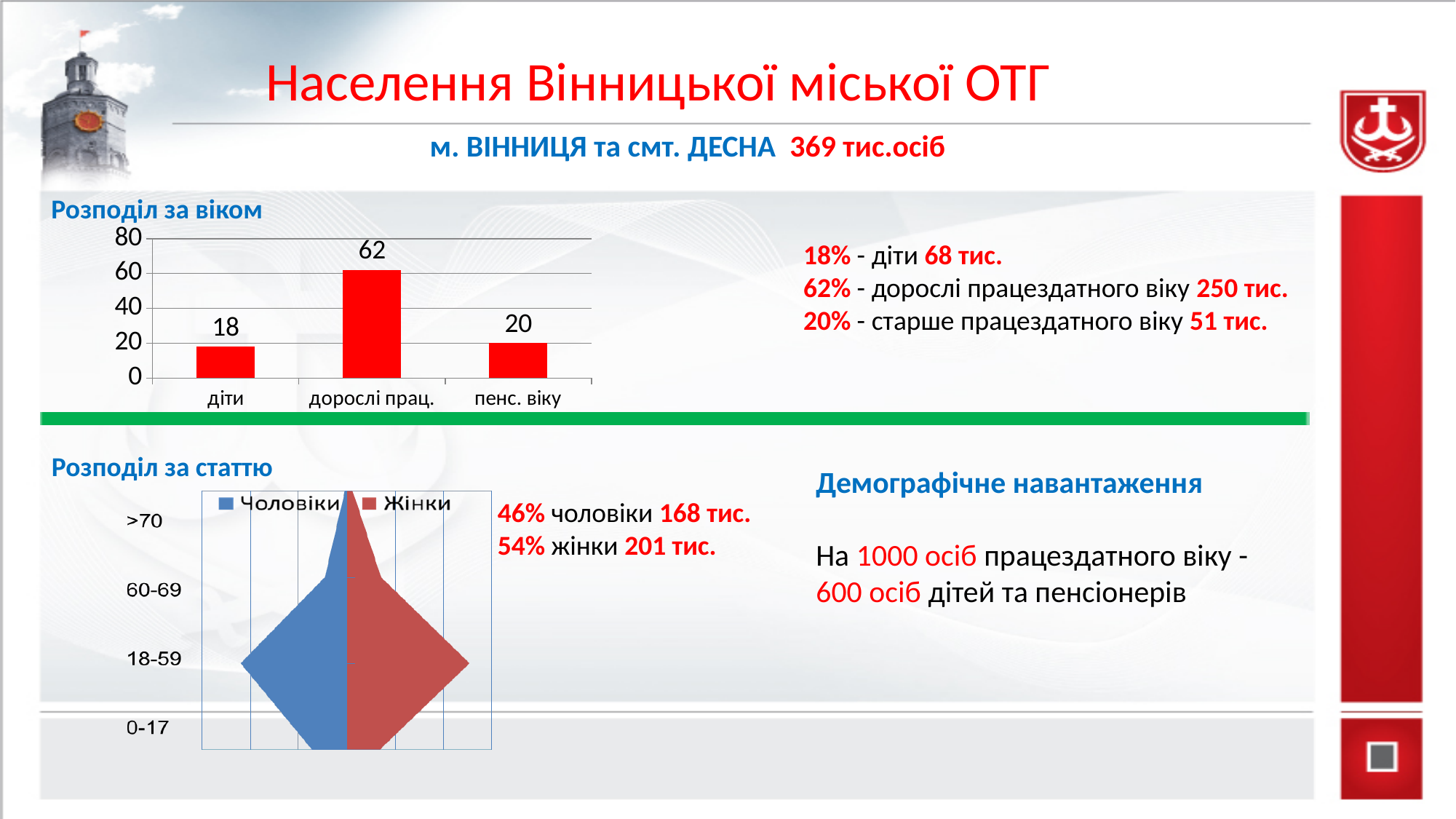
In the 'Розподіл за віком' chart, is the value for 'дорослі прац.' greater or less than 40? greater In the 'Розподіл за віком' chart, which category has the lowest value? діти In the 'Розподіл за віком' chart, what is the value for 'діти'? 18 How many series does the legend of the 'Розподіл за статтю' chart list? 2 In the 'Розподіл за статтю' chart, which colour represents 'Жінки'? red How many categories are shown in the 'Розподіл за віком' chart? 3 In the 'Розподіл за віком' chart, which is larger: the value for 'пенс. віку' or the value for 'діти'? пенс. віку In the 'Розподіл за віком' chart, what is the value for 'пенс. віку'? 20 In the 'Розподіл за віком' chart, what is the difference between the values for 'дорослі прац.' and 'пенс. віку'? 42 In the 'Розподіл за віком' chart, what is the value for 'дорослі прац.'? 62 What kind of chart is the 'Розподіл за віком' chart? bar chart In the 'Розподіл за віком' chart, which category has the highest value? дорослі прац.